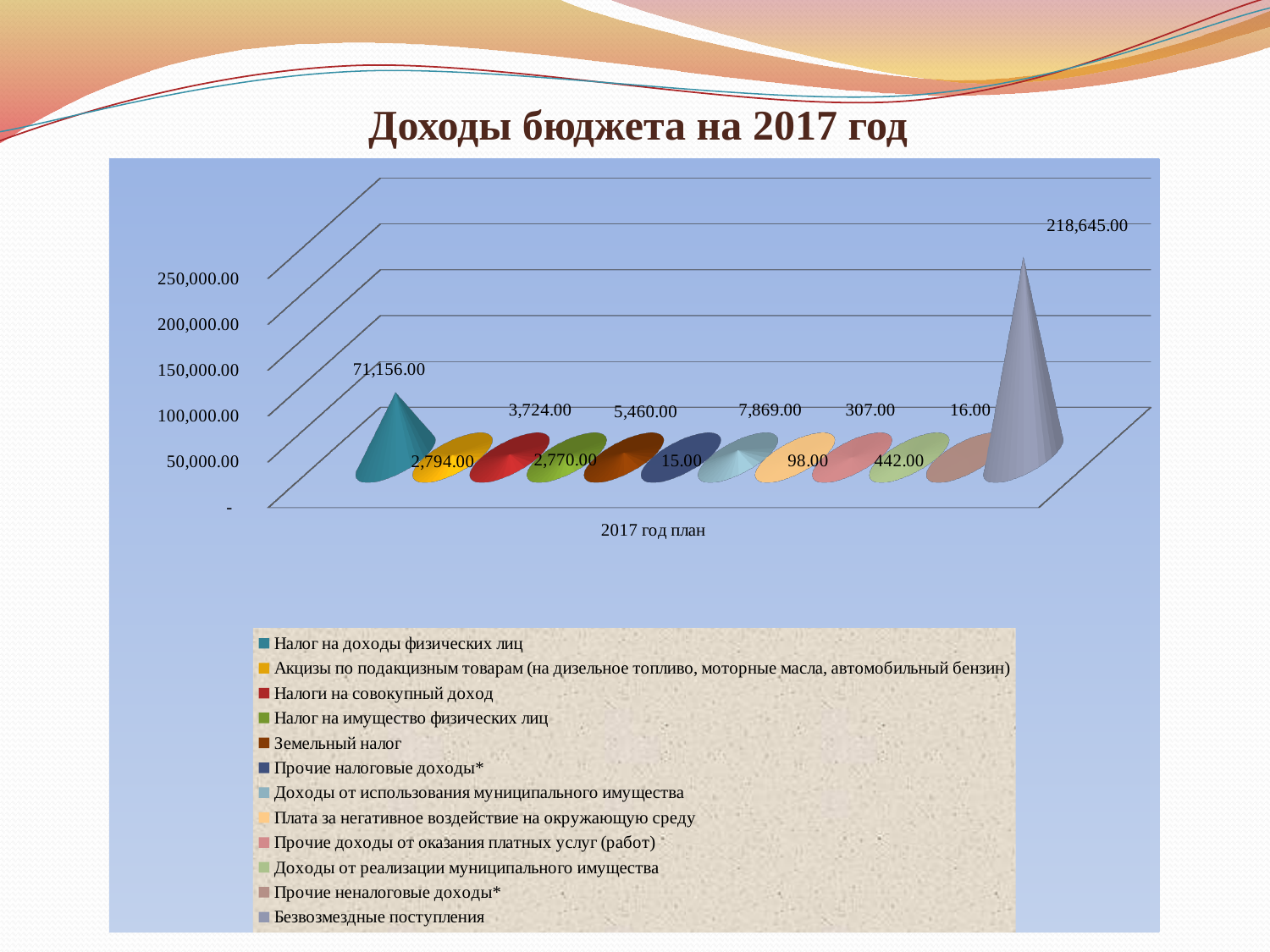
How many series does the legend list? 12 Which is larger: Налоги на совокупный доход or Налог на имущество физических лиц? Налоги на совокупный доход What is the value for Земельный налог? 5,460.00 What is the value for Налог на доходы физических лиц? 71,156.00 What is the title of the slide's chart? Доходы бюджета на 2017 год Which series has the highest value? Безвозмездные поступления Is the value for Безвозмездные поступления greater or less than 200,000.00? greater What is the category label on the x axis? 2017 год план What is the value for Доходы от использования муниципального имущества? 7,869.00 What is the value for Безвозмездные поступления? 218,645.00 Which series has the lowest value? Прочие налоговые доходы* What is the difference between Безвозмездные поступления and Налог на доходы физических лиц? 147,489.00